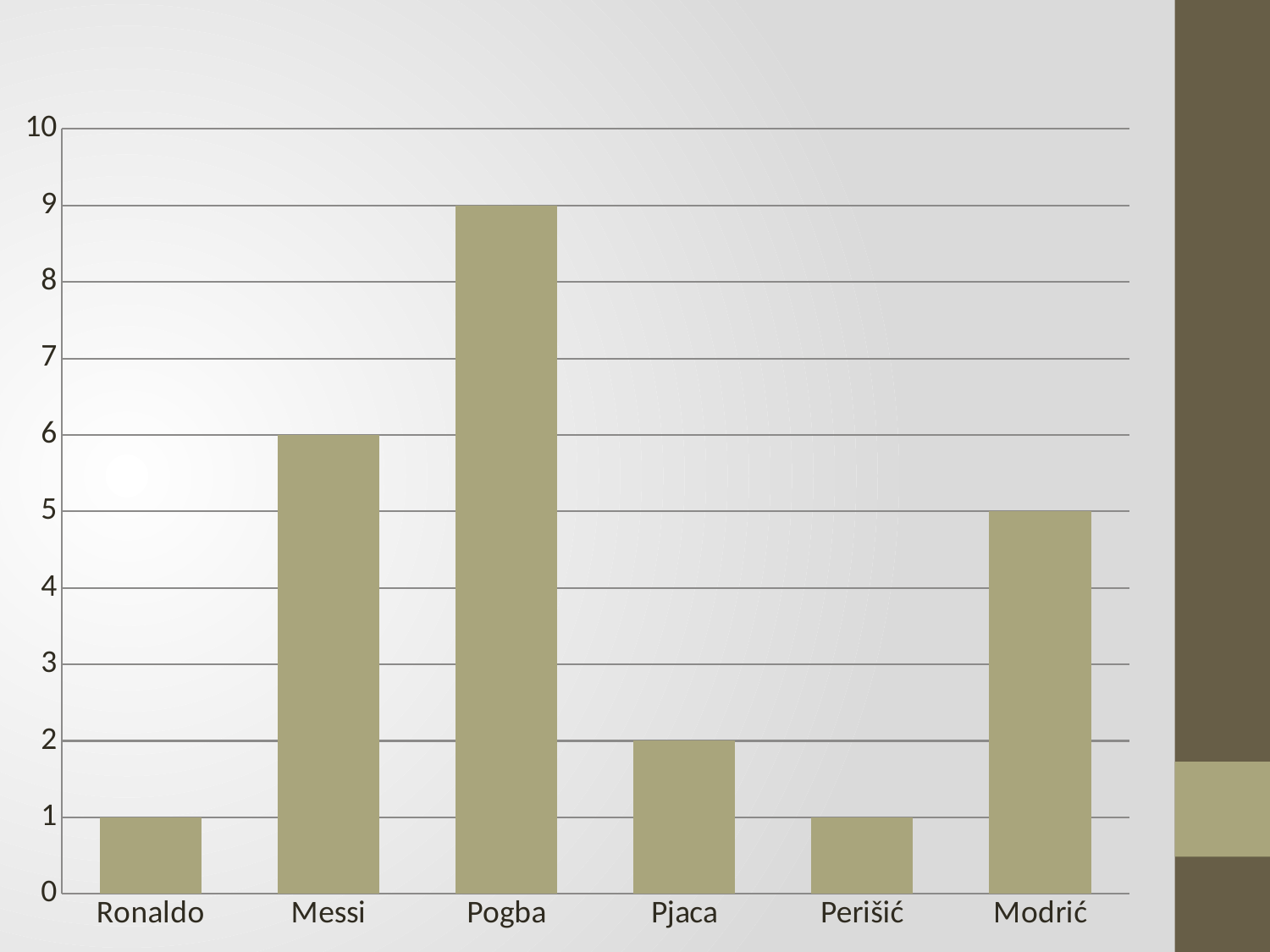
Which is larger, the value for Messi or the value for Modrić? Messi Is the value for Pogba greater or less than 8? greater What is the value for Pjaca? 2 What is the difference between the values for Pogba and Messi? 3 What is the value for Messi? 6 How many categories are shown on the x axis? 6 What kind of chart is shown on the slide? bar chart Which category has the highest bar? Pogba What is the highest value shown on the vertical axis? 10 What is the value for Modrić? 5 What is the difference between the values for Modrić and Pjaca? 3 What is the value for Pogba? 9